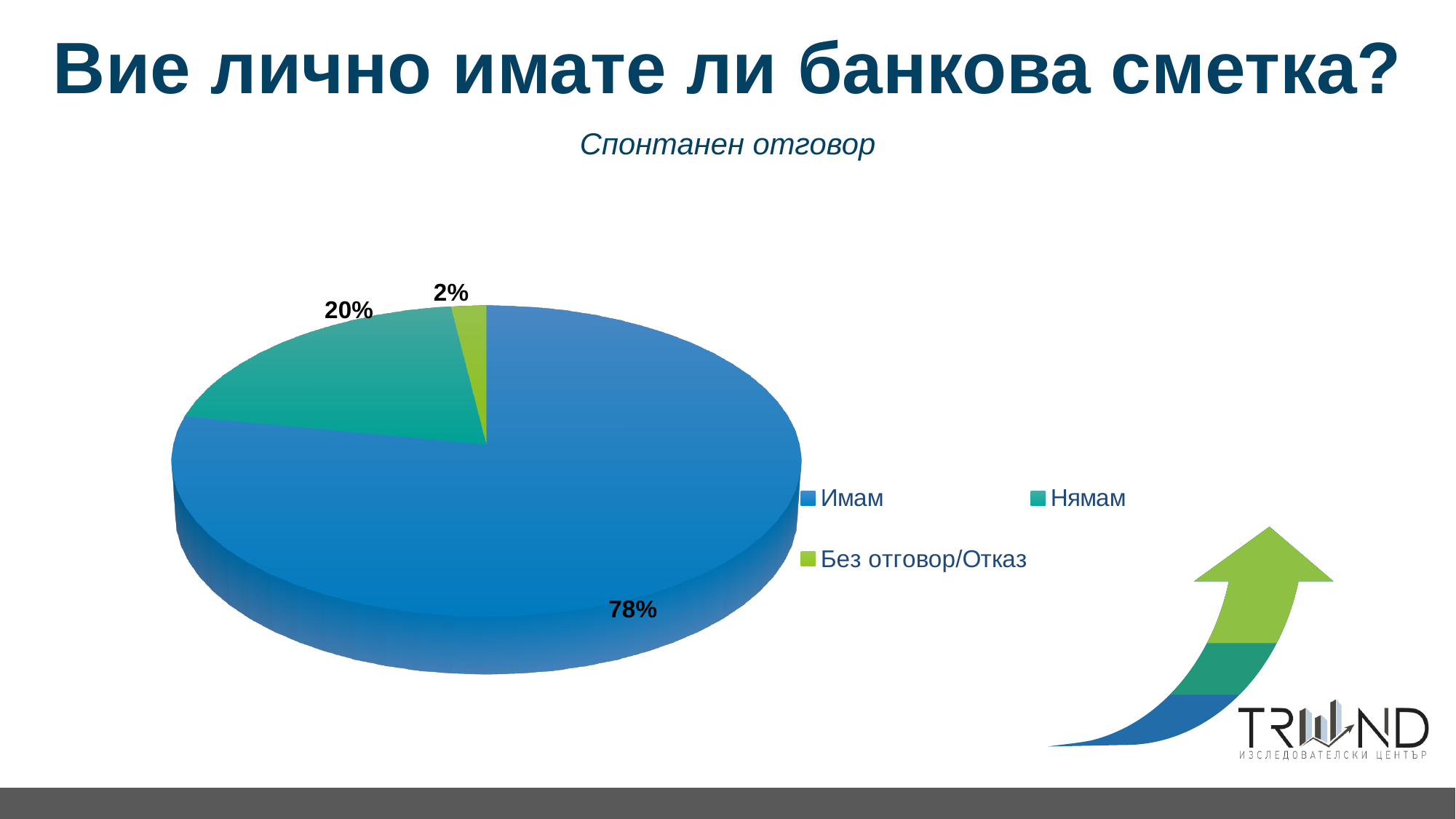
What is the difference in percentage points between the "Имам" and "Нямам" slices? 58 Which category has the smallest slice of the pie? Без отговор/Отказ What share of the pie does the "Имам" slice represent? 78% Which category has the largest slice of the pie? Имам What is the title of the slide above the chart? Вие лично имате ли банкова сметка? What kind of chart is shown on the slide? Pie chart Which is larger, the "Нямам" slice or the "Без отговор/Отказ" slice? Нямам What colour is the "Имам" slice in the pie chart? Blue What is the difference in percentage points between the "Нямам" and "Без отговор/Отказ" slices? 18 What share of the pie does the "Без отговор/Отказ" slice represent? 2% What share of the pie does the "Нямам" slice represent? 20% How many categories are shown in the pie chart? 3